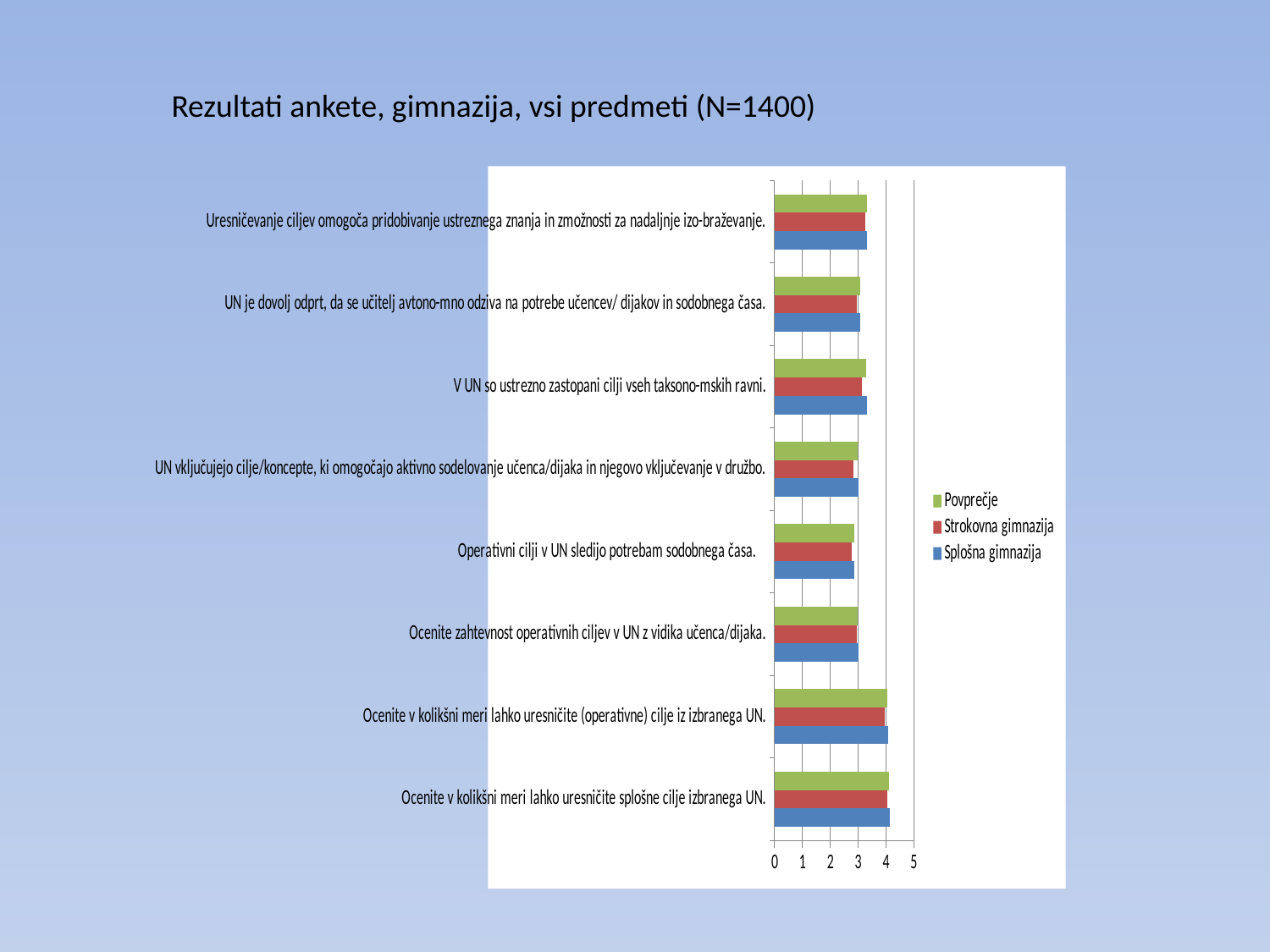
What kind of chart is shown on the slide? bar chart Is the Strokovna gimnazija value for 'Ocenite v kolikšni meri lahko uresničite (operativne) cilje iz izbranega UN.' greater or less than 3? greater Which series is shown in blue in the legend? Splošna gimnazija For the Povprečje series, which is larger: the value for 'Ocenite v kolikšni meri lahko uresničite splošne cilje izbranega UN.' or the value for 'Operativni cilji v UN sledijo potrebam sodobnega časa.'? Ocenite v kolikšni meri lahko uresničite splošne cilje izbranega UN. For the Splošna gimnazija series, which is larger: the value for 'Ocenite v kolikšni meri lahko uresničite (operativne) cilje iz izbranega UN.' or the value for 'Ocenite zahtevnost operativnih ciljev v UN z vidika učenca/dijaka.'? Ocenite v kolikšni meri lahko uresničite (operativne) cilje iz izbranega UN. How many series does the legend list? 3 Is the Strokovna gimnazija value for 'V UN so ustrezno zastopani cilji vseh taksono-mskih ravni.' greater or less than 2? greater How many categories (survey statements) are plotted on the chart? 8 What is the title of the slide containing the chart? Rezultati ankete, gimnazija, vsi predmeti (N=1400) Is the Povprečje value for 'Ocenite v kolikšni meri lahko uresničite splošne cilje izbranega UN.' greater or less than 3? greater